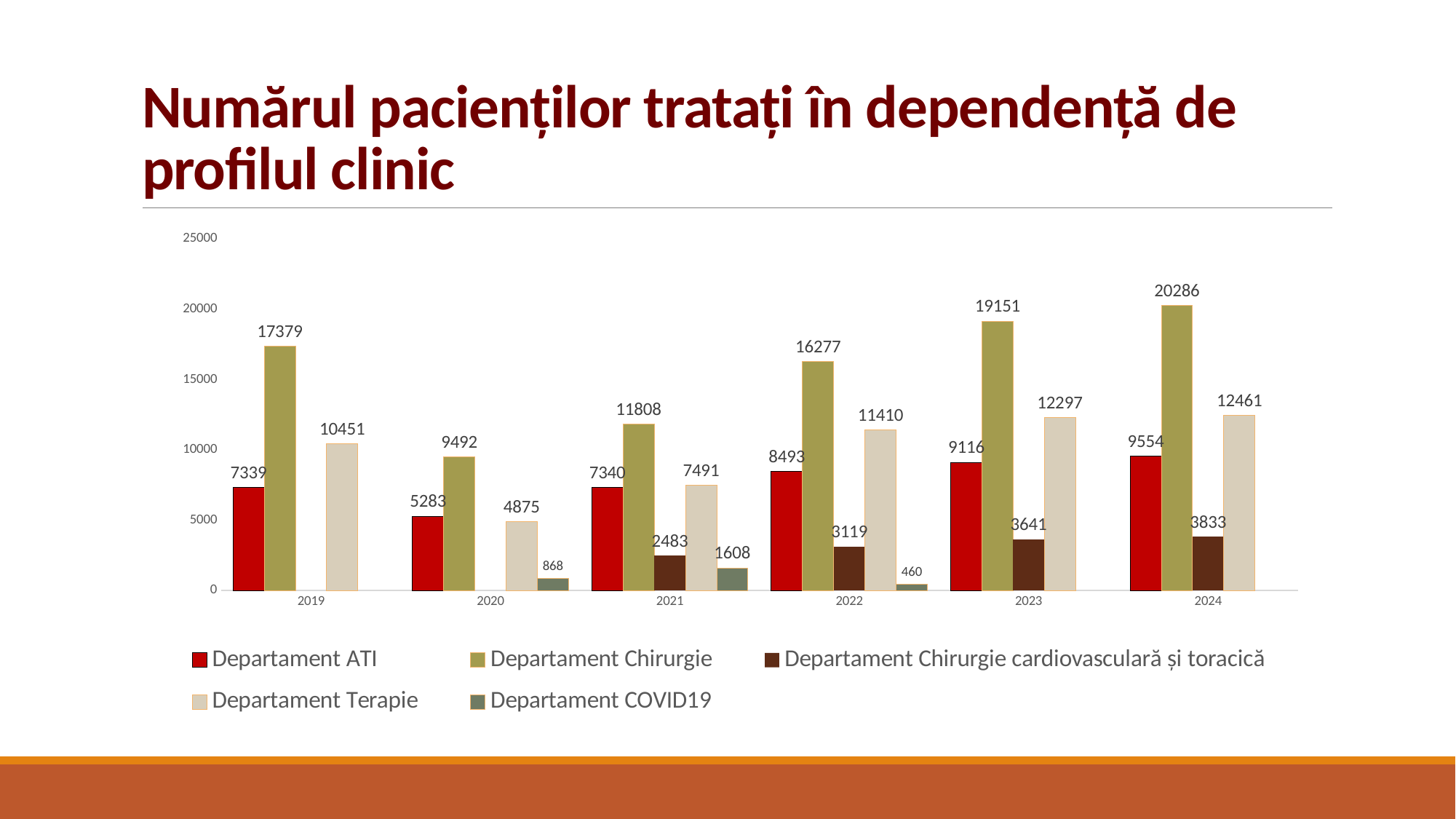
How many years are shown on the x axis? 6 In which year is the value for Departament ATI the lowest? 2020 What is the value for Departament Terapie in 2023? 12297 What is the difference between Departament Chirurgie and Departament ATI in 2019? 10040 What is the value for Departament Chirurgie in 2024? 20286 What is the value for Departament ATI in 2020? 5283 What is the value for Departament COVID19 in 2022? 460 What type of chart is shown on the slide? bar chart Does the value for Departament Chirurgie rise or fall from 2020 to 2024? rise How many series does the legend list? 5 In which year is the value for Departament Chirurgie the highest? 2024 Which is larger in 2021: Departament Terapie or Departament ATI? Departament Terapie